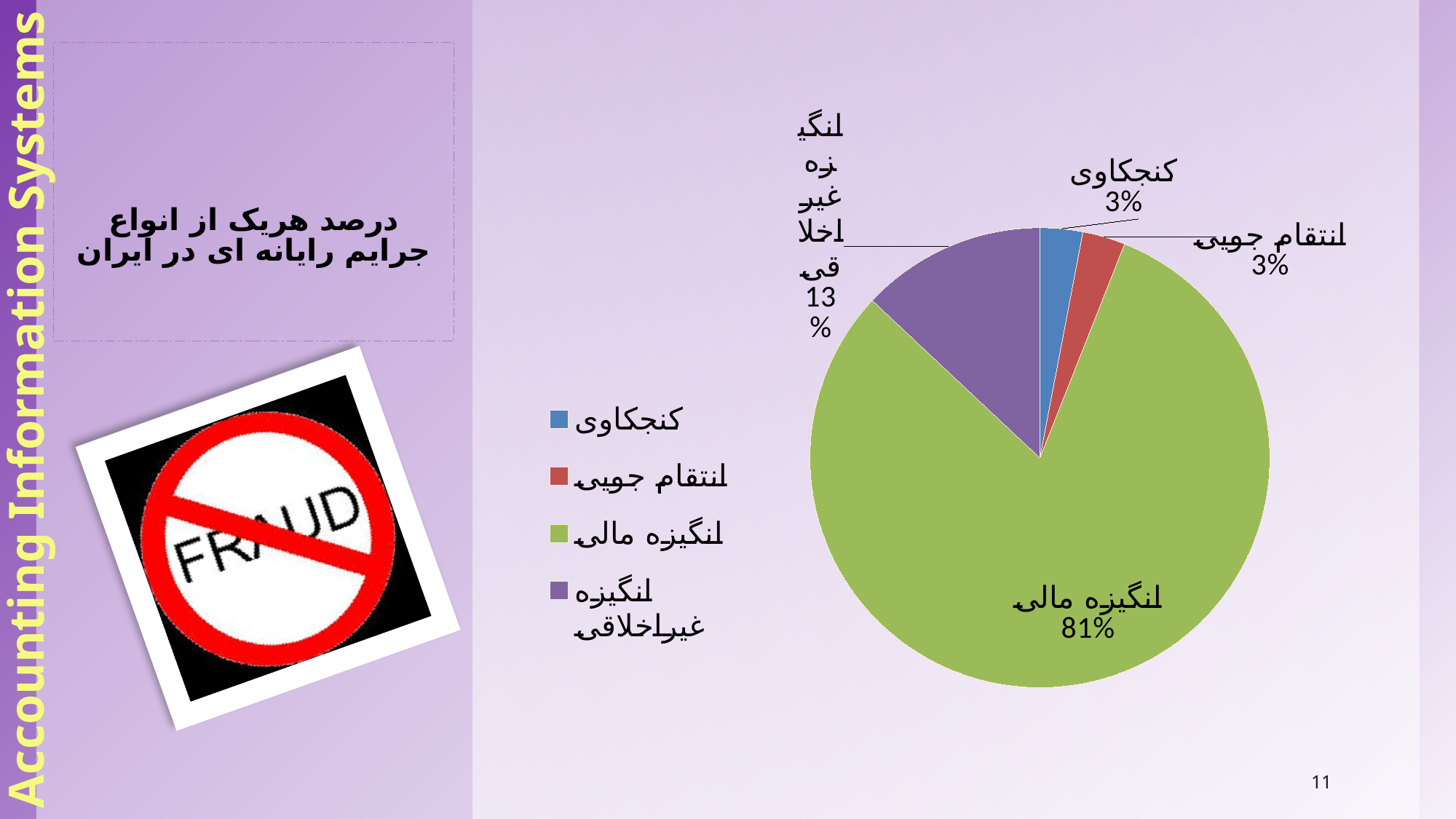
What percentage is shown for کنجکاوی? 3% How many entries does the legend list? 4 Which is larger, the share for انگیزه غیراخلاقی or the share for کنجکاوی? انگیزه غیراخلاقی What is the difference in percentage points between انگیزه مالی and انگیزه غیراخلاقی? 68 What colour is the slice for انگیزه مالی? green What percentage is shown for انگیزه غیراخلاقی? 13% What type of chart is shown on the slide? pie chart Which two categories share the smallest slice of the pie? کنجکاوی and انتقام جویی What percentage is shown for انتقام جویی? 3% How many slices does the pie chart have? 4 What percentage of the pie is labelled for انگیزه مالی? 81% Which category has the largest share of the pie? انگیزه مالی